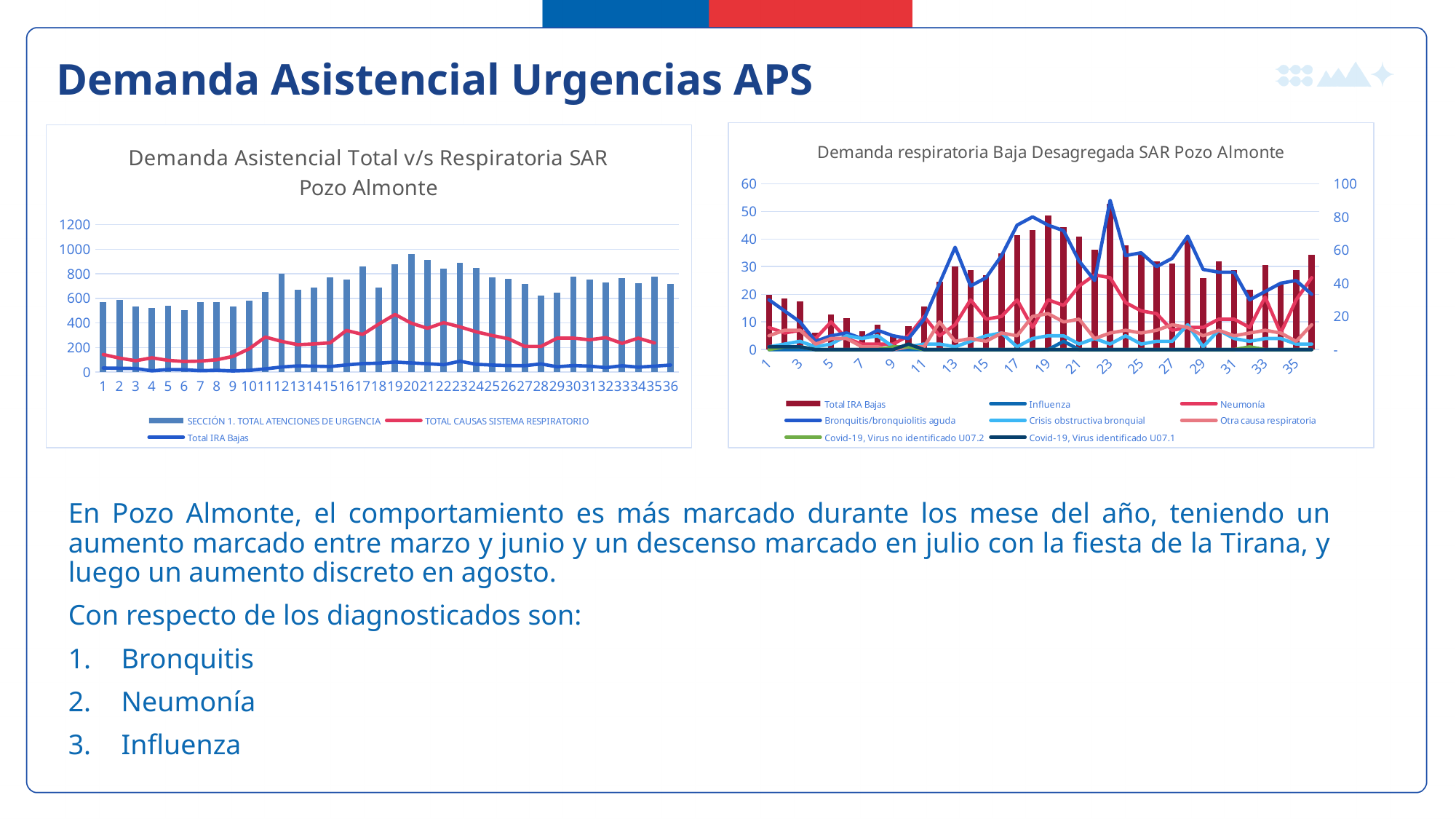
In the chart on the left (Demanda Asistencial Total v/s Respiratoria SAR Pozo Almonte), how many series does the legend list? 3 What kind of chart is the chart on the right (Demanda respiratoria Baja Desagregada SAR Pozo Almonte)? Bar chart with line series In the chart on the left (Demanda Asistencial Total v/s Respiratoria SAR Pozo Almonte), which is larger: the SECCIÓN 1. TOTAL ATENCIONES DE URGENCIA bar at point 20 or at point 1? Point 20 In the chart on the left (Demanda Asistencial Total v/s Respiratoria SAR Pozo Almonte), is the SECCIÓN 1. TOTAL ATENCIONES DE URGENCIA bar at point 28 greater or less than 800? less In the chart on the left (Demanda Asistencial Total v/s Respiratoria SAR Pozo Almonte), at which x-axis point is the SECCIÓN 1. TOTAL ATENCIONES DE URGENCIA bar highest? 20 In the chart on the right (Demanda respiratoria Baja Desagregada SAR Pozo Almonte), how many series does the legend list? 8 In the chart on the left (Demanda Asistencial Total v/s Respiratoria SAR Pozo Almonte), is the SECCIÓN 1. TOTAL ATENCIONES DE URGENCIA bar at point 20 greater or less than 800? greater In the chart on the right (Demanda respiratoria Baja Desagregada SAR Pozo Almonte), at which x-axis point is the Total IRA Bajas bar highest? 23 In the chart on the right (Demanda respiratoria Baja Desagregada SAR Pozo Almonte), is the Total IRA Bajas bar at point 19 greater or less than 40 on the left axis? greater In the chart on the left (Demanda Asistencial Total v/s Respiratoria SAR Pozo Almonte), how many points are shown along the x axis? 36 What is the title of the chart on the left of the slide? Demanda Asistencial Total v/s Respiratoria SAR Pozo Almonte In the chart on the right (Demanda respiratoria Baja Desagregada SAR Pozo Almonte), do the Total IRA Bajas bars rise or fall between point 11 and point 19? Rise